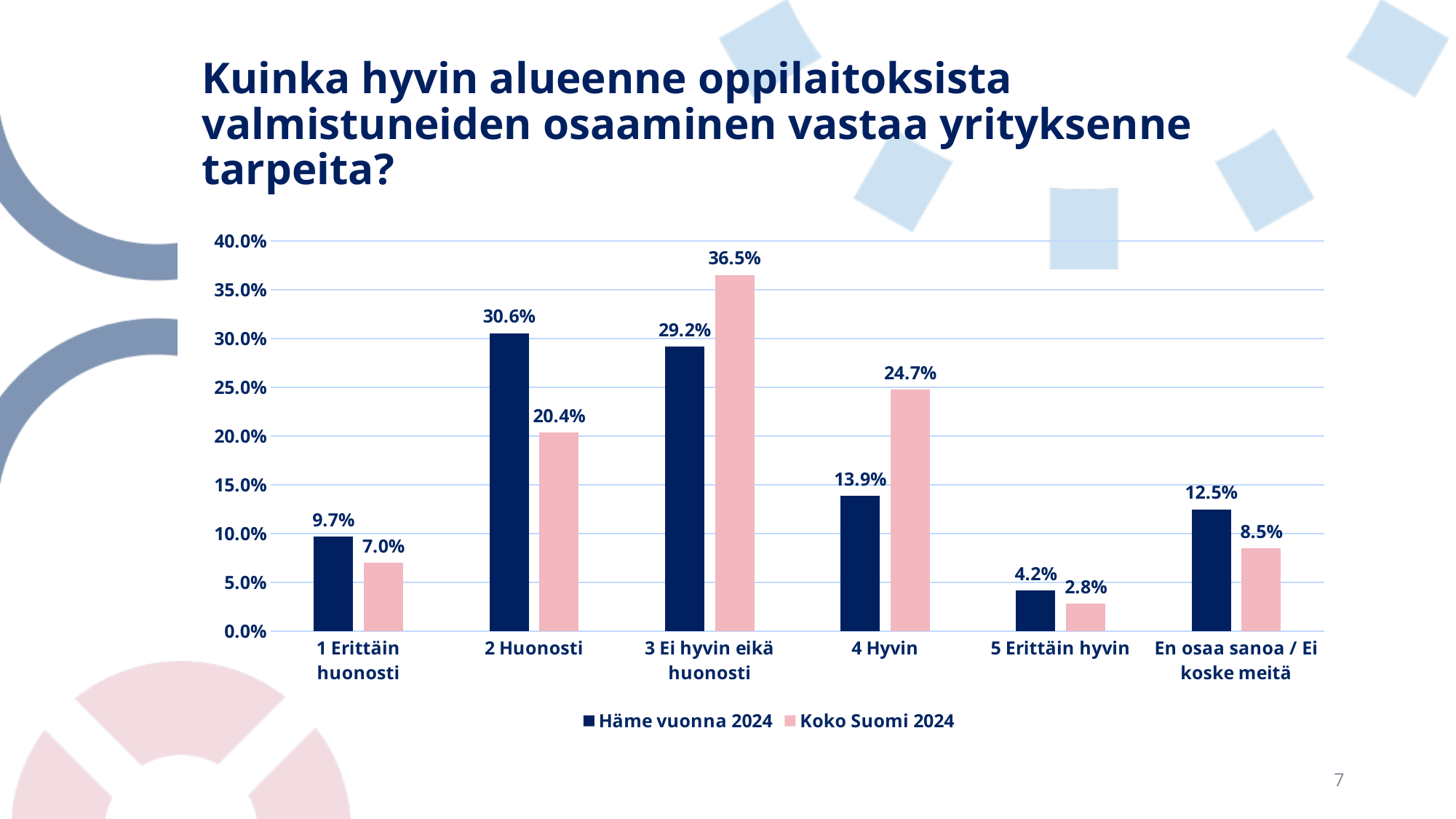
Is the value for Koko Suomi 2024 in '2 Huonosti' greater or less than 25.0%? less What kind of chart is shown on the slide? Bar chart How many series does the legend list? 2 Which is larger in the category '1 Erittäin huonosti': Häme vuonna 2024 or Koko Suomi 2024? Häme vuonna 2024 What is the value for Koko Suomi 2024 in the category '3 Ei hyvin eikä huonosti'? 36.5% What is the value for Häme vuonna 2024 in the category '2 Huonosti'? 30.6% Which category has the highest value for Häme vuonna 2024? 2 Huonosti What is the value for Koko Suomi 2024 in the category '5 Erittäin hyvin'? 2.8% What is the difference between Koko Suomi 2024 and Häme vuonna 2024 in the category '4 Hyvin'? 10.8% How many categories are shown on the x axis? 6 Which category has the lowest value for Koko Suomi 2024? 5 Erittäin hyvin Which series is shown in pink in the legend? Koko Suomi 2024